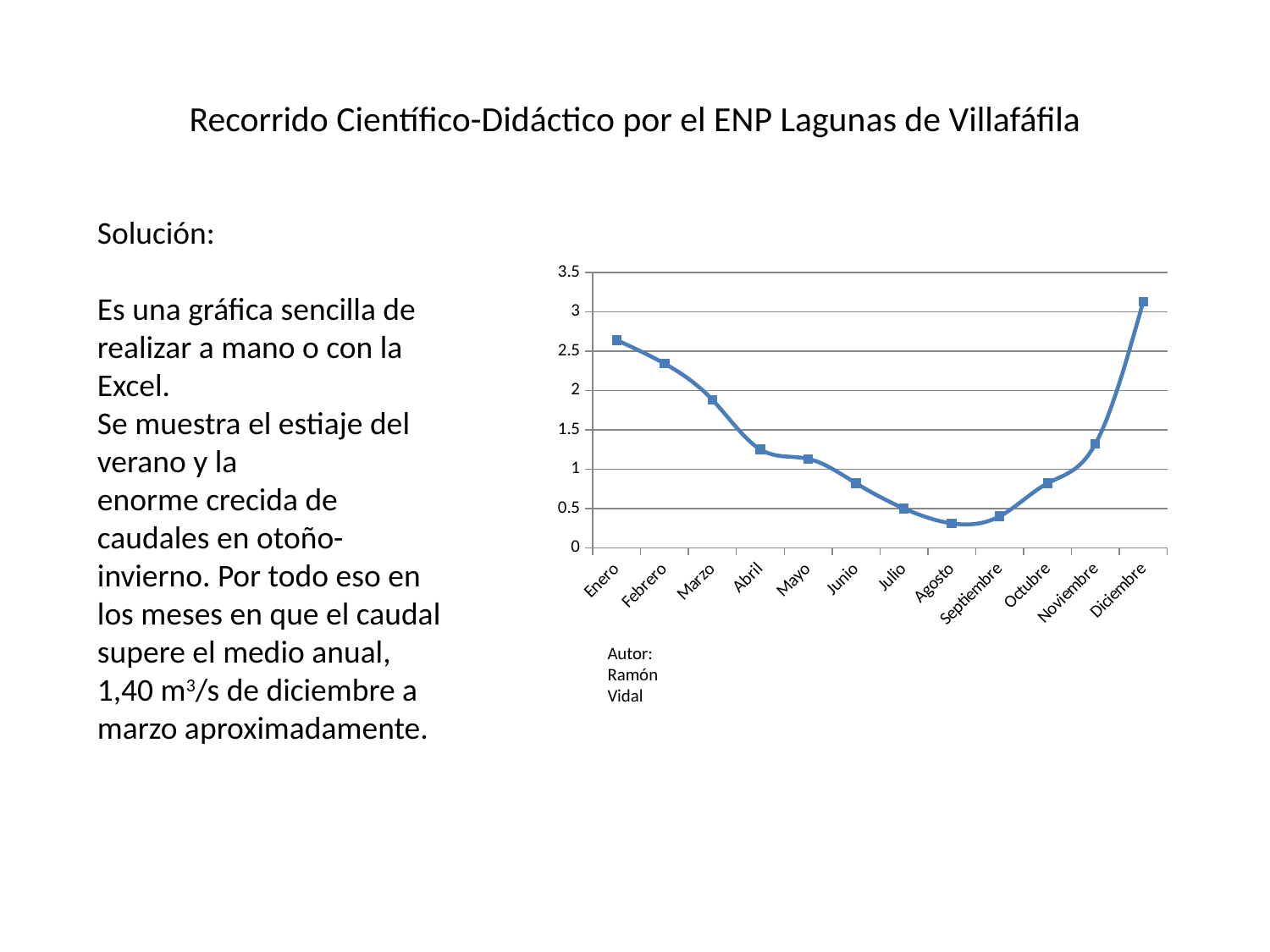
Which month has the lowest value in the chart? Agosto How many months are plotted along the x axis of the chart? 12 Do the values rise or fall from Enero to Agosto? fall Which is larger, the value for Enero or the value for Febrero? Enero Is the value for Noviembre greater or less than 1? greater Is the value for Diciembre greater or less than 3? greater Which is larger, the value for Marzo or the value for Noviembre? Marzo Is the value for Marzo greater or less than 2? less Which month has the highest value in the chart? Diciembre What kind of chart is shown on the slide? line chart